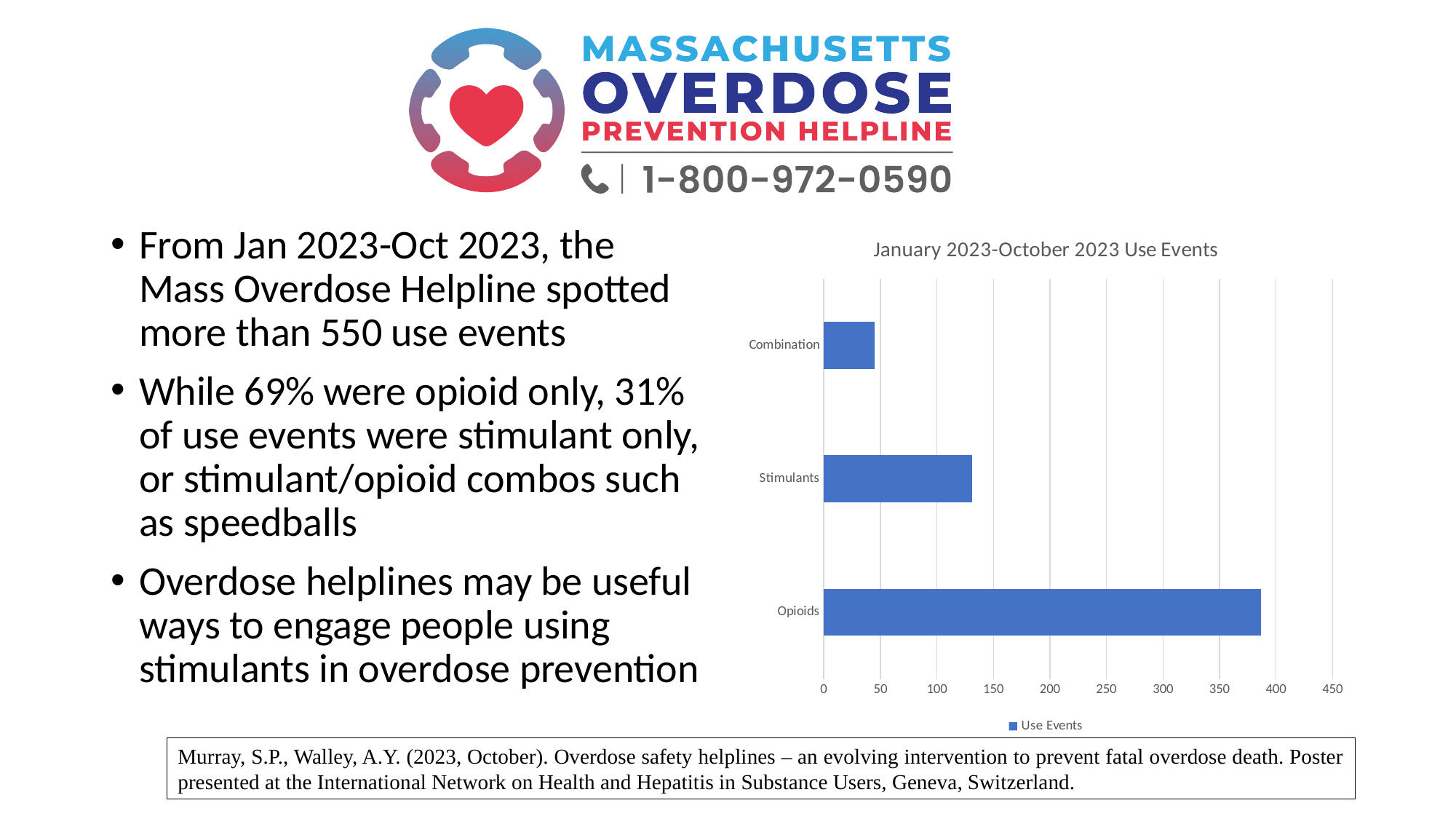
Which has more use events, Stimulants or Combination? Stimulants How many categories are plotted in the chart? 3 Which category has the lowest number of use events? Combination What series name appears in the chart legend? Use Events Which category has the highest number of use events? Opioids How many series does the chart legend list? 1 What kind of chart is shown on the slide? Bar chart What is the title of the chart? January 2023-October 2023 Use Events Is the value for Stimulants greater or less than 150? less Is the value for Combination greater or less than 100? less Is the value for Opioids greater or less than 350? greater